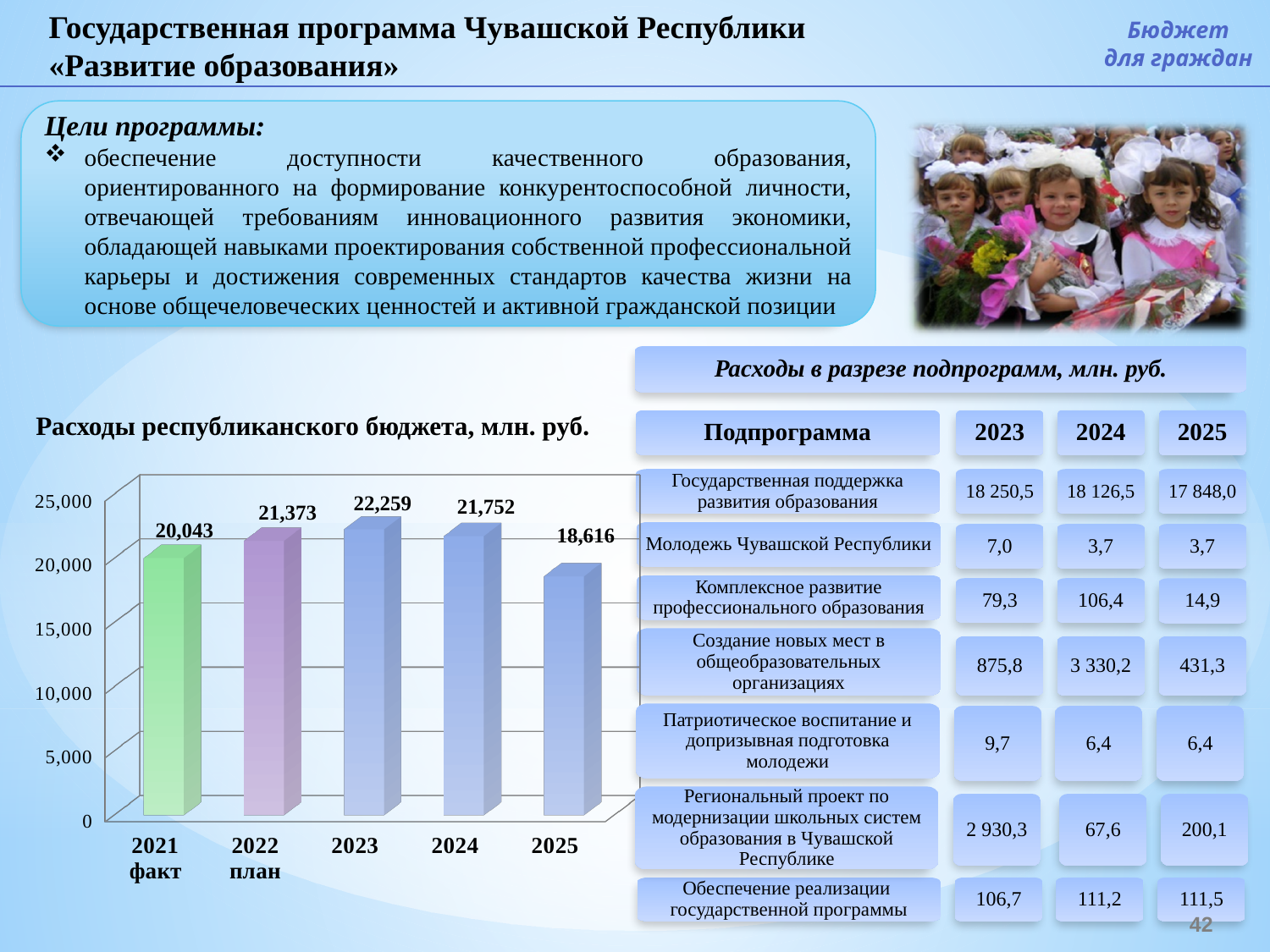
In the chart 'Расходы республиканского бюджета, млн. руб.', is the value for 2025 greater or less than 20,000? less What is the value for 2021 факт in the chart 'Расходы республиканского бюджета, млн. руб.'? 20,043 Which year has the highest value in the chart 'Расходы республиканского бюджета, млн. руб.'? 2023 What type of chart is 'Расходы республиканского бюджета, млн. руб.'? bar chart In the chart 'Расходы республиканского бюджета, млн. руб.', which is larger: the value for 2024 or the value for 2022 план? 2024 Which year has the lowest value in the chart 'Расходы республиканского бюджета, млн. руб.'? 2025 In the chart 'Расходы республиканского бюджета, млн. руб.', do the values rise or fall from 2023 to 2025? fall How many bars are shown in the chart 'Расходы республиканского бюджета, млн. руб.'? 5 What is the value for 2025 in the chart 'Расходы республиканского бюджета, млн. руб.'? 18,616 What is the value for 2023 in the chart 'Расходы республиканского бюджета, млн. руб.'? 22,259 What is the difference between the values for 2022 план and 2021 факт in the chart 'Расходы республиканского бюджета, млн. руб.'? 1,330 What is the difference between the values for 2023 and 2025 in the chart 'Расходы республиканского бюджета, млн. руб.'? 3,643